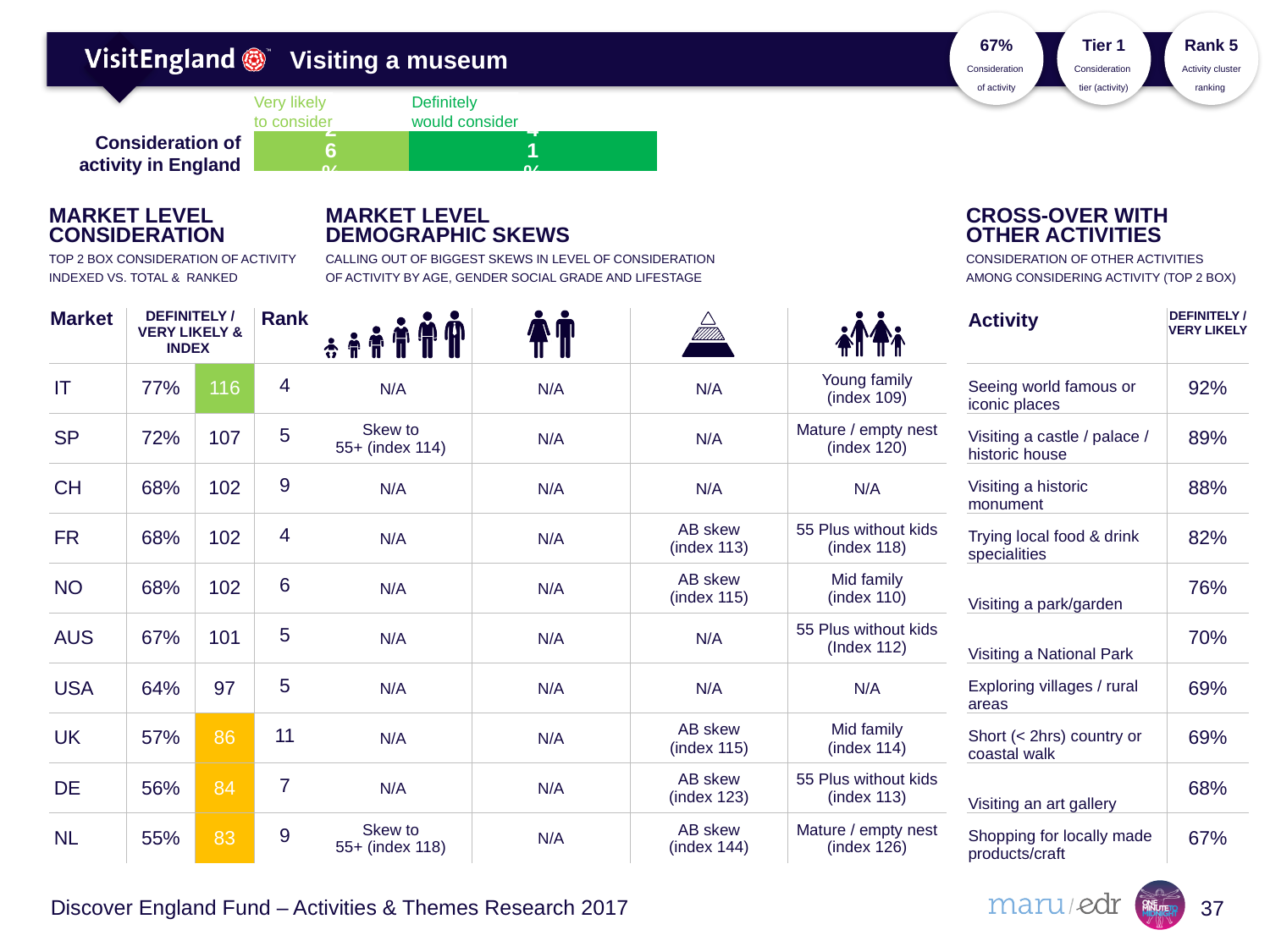
In the 'Consideration of activity in England' bar chart, what is the value for 'Very likely to consider'? 26% How many series does the legend of the 'Consideration of activity in England' bar chart list? 2 How many categories (bars) are plotted in the 'Consideration of activity in England' chart? 1 In the 'Consideration of activity in England' chart, which legend entry is shown in the lighter green colour? Very likely to consider In the 'Consideration of activity in England' bar chart, what is the value for 'Definitely would consider'? 41% What is the total of the stacked bar for 'Consideration of activity in England'? 67% What is the category label of the single stacked bar in the chart at the top of the slide? Consideration of activity in England In the 'Consideration of activity in England' bar chart, which segment is larger: 'Very likely to consider' or 'Definitely would consider'? Definitely would consider What kind of chart is shown under the 'Visiting a museum' heading for consideration of activity in England? bar chart